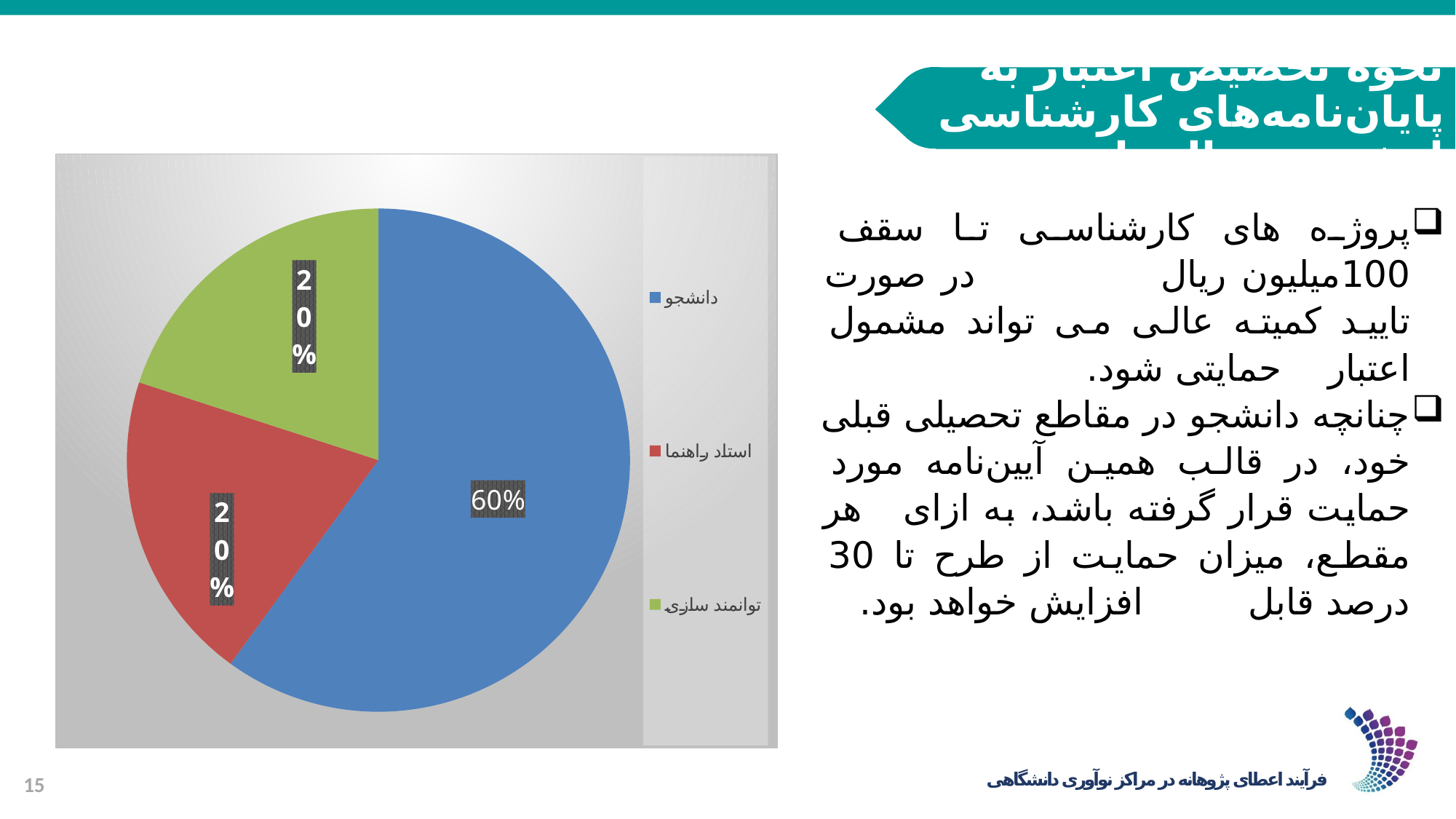
Which category has the largest slice of the pie? دانشجو What share of the pie does the دانشجو slice represent? 60% What kind of chart is shown on the slide? pie chart What colour is the دانشجو slice in the pie chart? blue What share of the pie does the استاد راهنما slice represent? 20% What share of the pie does the توانمند سازی slice represent? 20% How many slices does the pie chart have? 3 Which is larger, the دانشجو slice or the توانمند سازی slice? دانشجو What is the difference between the دانشجو share and the استاد راهنما share? 40% What colour is the استاد راهنما slice in the pie chart? red Is the share for دانشجو greater or less than 50%? greater How many entries does the legend list? 3